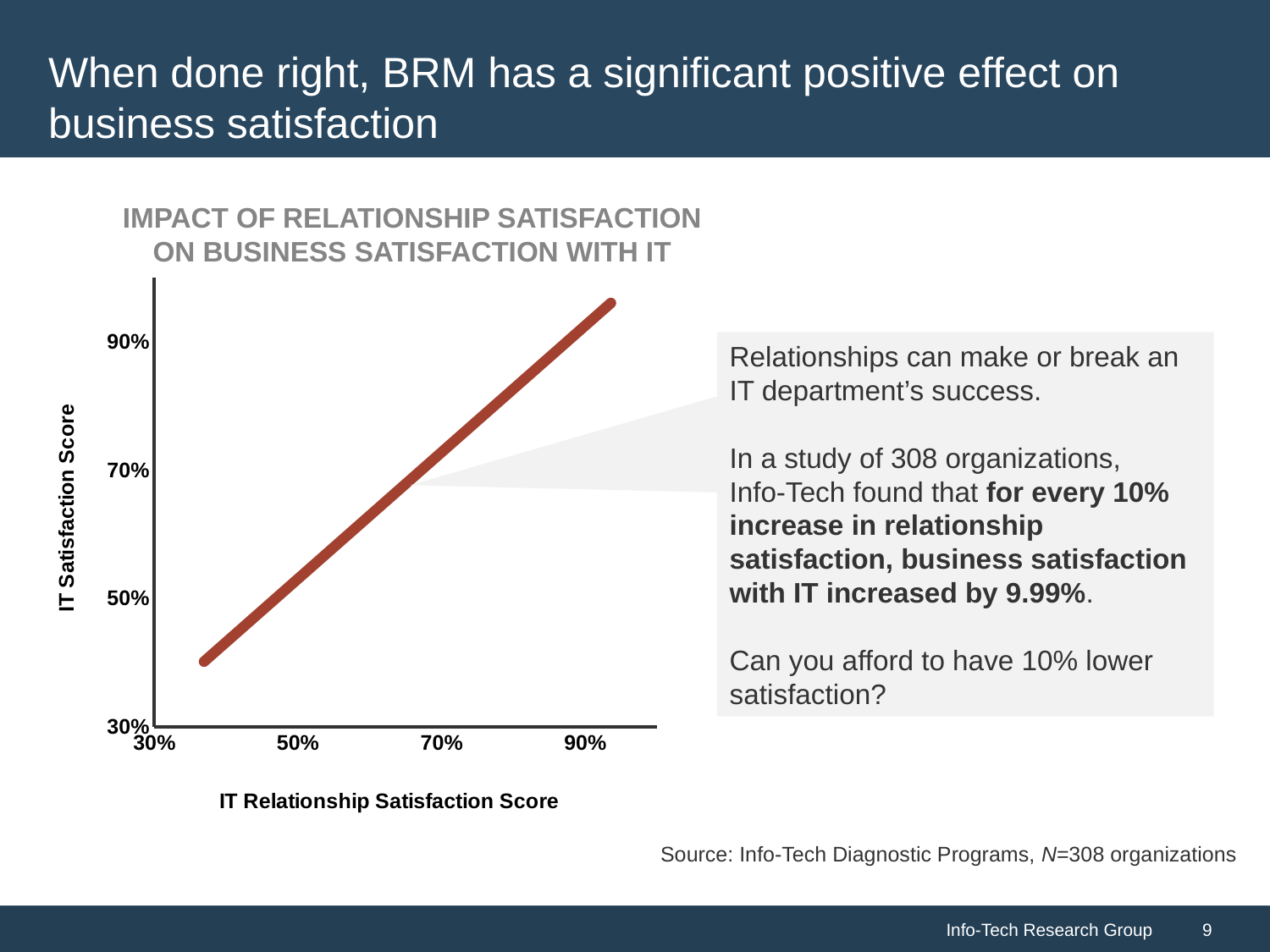
Is the IT Satisfaction Score at the lowest plotted point of the line greater or less than 50%? less What is the label of the x axis of the chart? IT Relationship Satisfaction Score Is the IT Satisfaction Score at the lowest plotted point of the line greater or less than 30%? greater What kind of chart is shown on the slide? line chart What is the title of the chart? IMPACT OF RELATIONSHIP SATISFACTION ON BUSINESS SATISFACTION WITH IT Does the IT Satisfaction Score rise or fall as the IT Relationship Satisfaction Score increases along the x axis? rise Is the IT Satisfaction Score at an IT Relationship Satisfaction Score of 50% greater or less than 70%? less